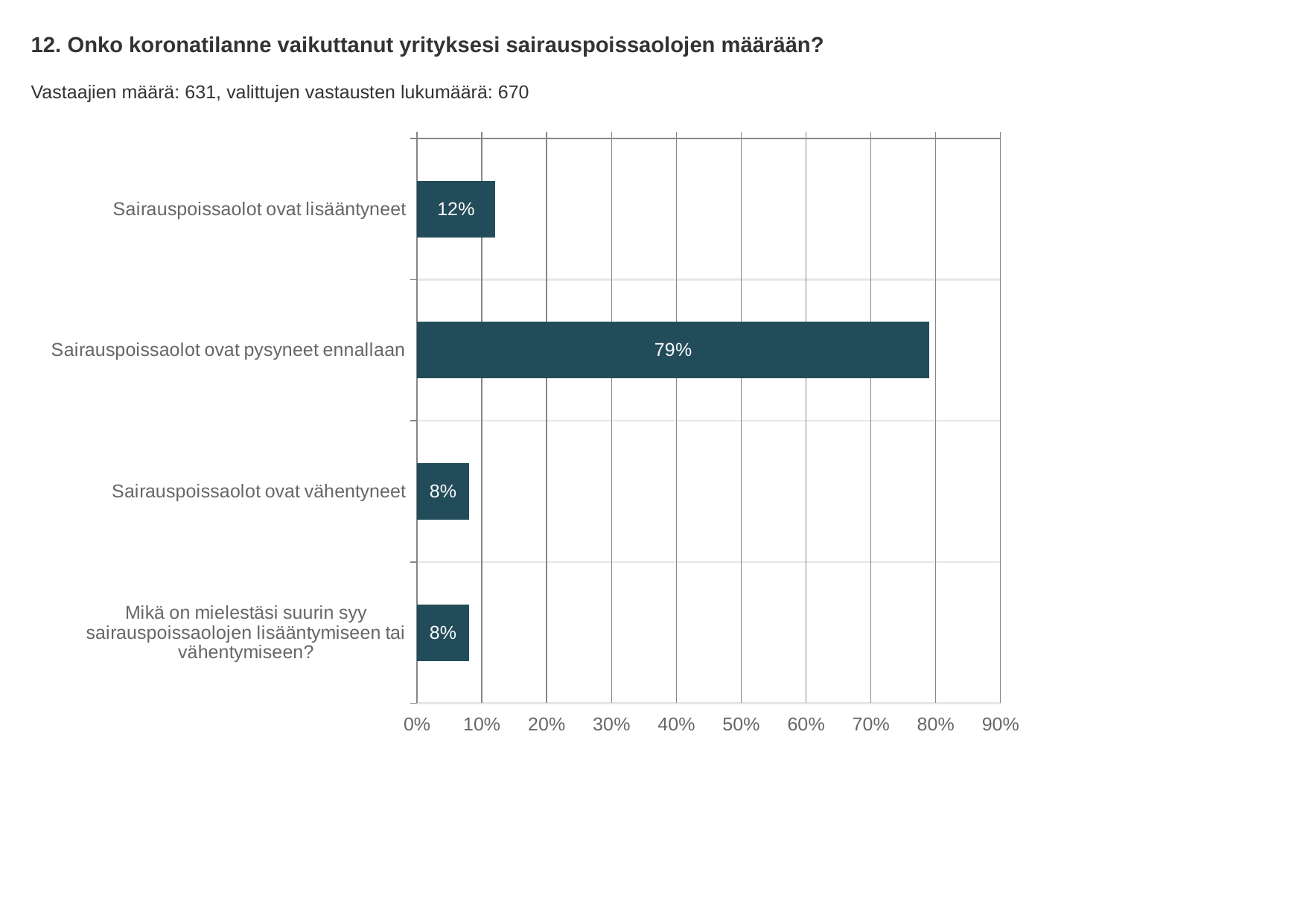
What percentage of respondents chose "Sairauspoissaolot ovat lisääntyneet"? 12% Which is larger: "Sairauspoissaolot ovat lisääntyneet" or "Sairauspoissaolot ovat vähentyneet"? Sairauspoissaolot ovat lisääntyneet What percentage of respondents chose "Sairauspoissaolot ovat pysyneet ennallaan"? 79% Is the value for "Sairauspoissaolot ovat lisääntyneet" greater or less than 20%? less Which category has the highest value? Sairauspoissaolot ovat pysyneet ennallaan What percentage of respondents chose "Sairauspoissaolot ovat vähentyneet"? 8% Is the value for "Sairauspoissaolot ovat pysyneet ennallaan" greater or less than 70%? greater What is the difference between "Sairauspoissaolot ovat lisääntyneet" and "Sairauspoissaolot ovat vähentyneet"? 4% How many categories are shown in the chart? 4 What is the number of respondents (Vastaajien määrä) stated on the slide? 631 What kind of chart is shown on the slide? Bar chart What is the difference between "Sairauspoissaolot ovat pysyneet ennallaan" and "Sairauspoissaolot ovat lisääntyneet"? 67%